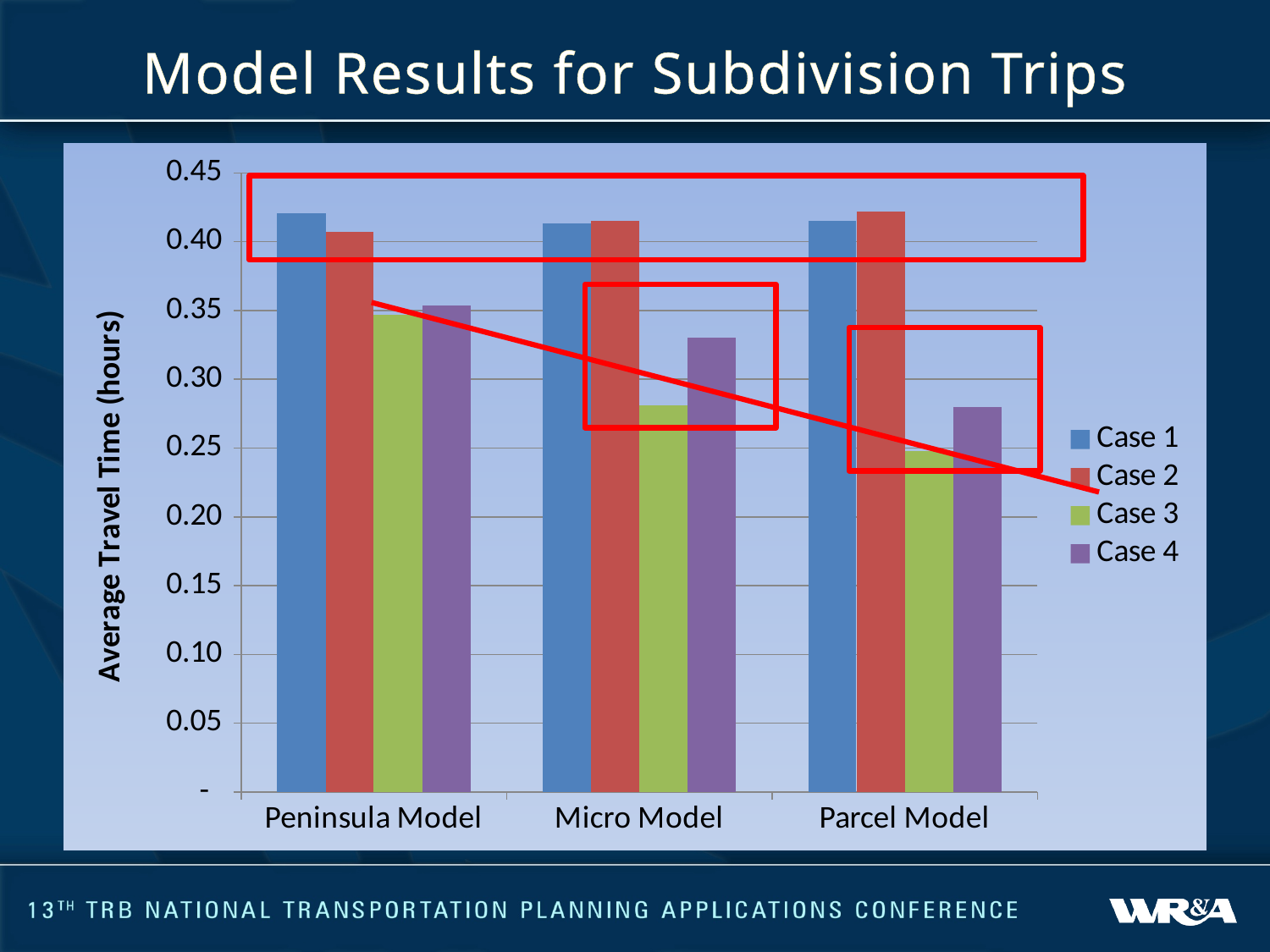
Is the Case 1 value for the Peninsula Model greater or less than 0.40? greater Which is larger, the Case 4 value for the Micro Model or the Case 4 value for the Parcel Model? Micro Model Is the Case 4 value for the Micro Model greater or less than 0.30? greater How many model categories are shown on the x axis? 3 Which model has the lowest Case 3 value? Parcel Model What is the title of the y axis? Average Travel Time (hours) Is the Case 3 value for the Parcel Model greater or less than 0.30? less Which is larger, the Case 3 value for the Peninsula Model or the Case 3 value for the Parcel Model? Peninsula Model Do the Case 3 values rise or fall from the Peninsula Model to the Parcel Model? fall Within the Micro Model group, which case has the lowest value? Case 3 How many series does the legend list? 4 What kind of chart is shown on the slide? bar chart